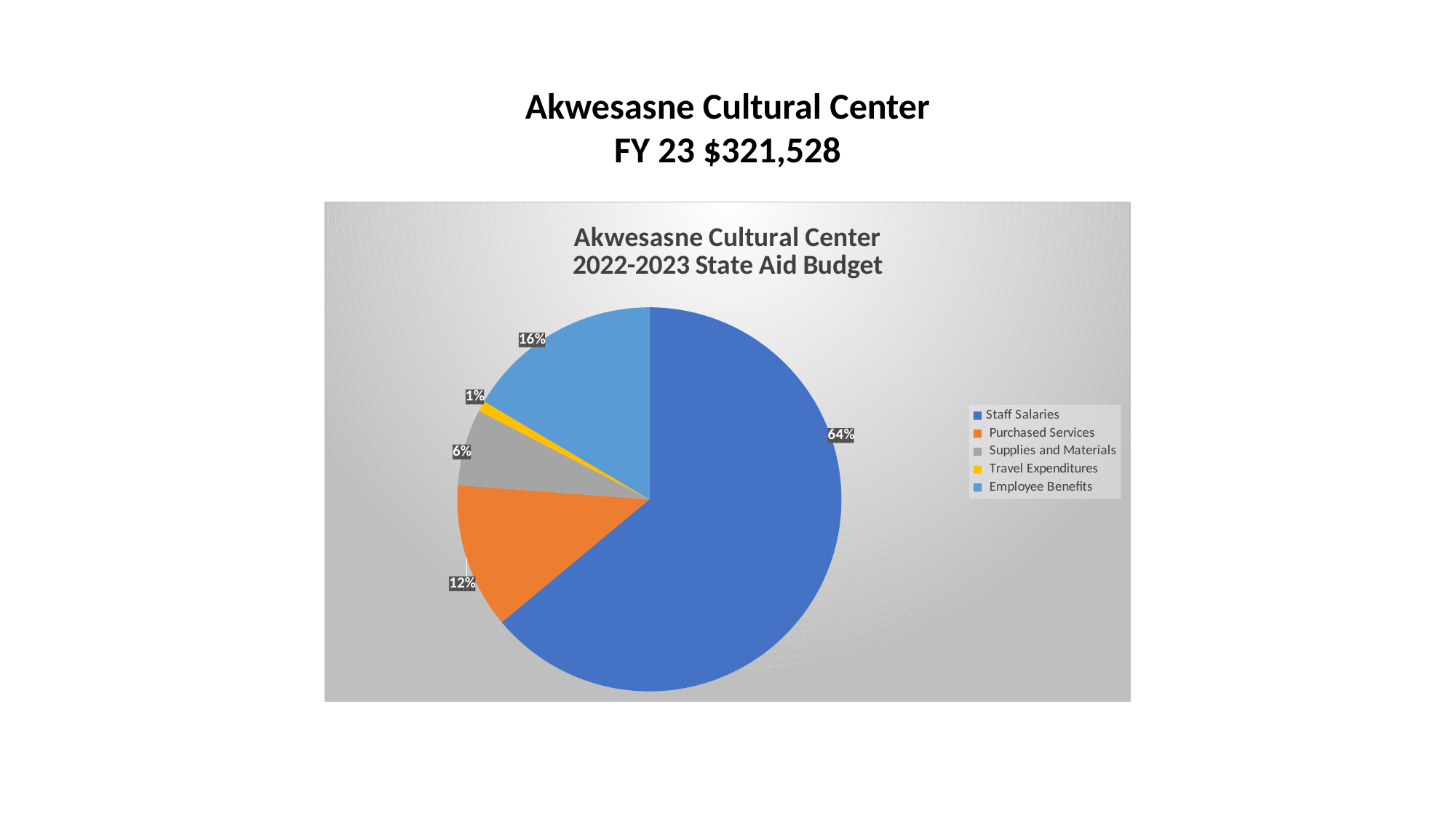
What is the difference in percentage points between Staff Salaries and Employee Benefits? 48 percentage points Which category has the smallest share of the budget? Travel Expenditures What share of the budget goes to Employee Benefits? 16% What type of chart is shown on the slide? Pie chart What is the title of the chart? Akwesasne Cultural Center 2022-2023 State Aid Budget What share of the budget goes to Staff Salaries? 64% What share of the budget goes to Travel Expenditures? 1% Which category has the largest share of the budget? Staff Salaries Which is larger, the share for Employee Benefits or the share for Purchased Services? Employee Benefits How many categories does the pie chart show? 5